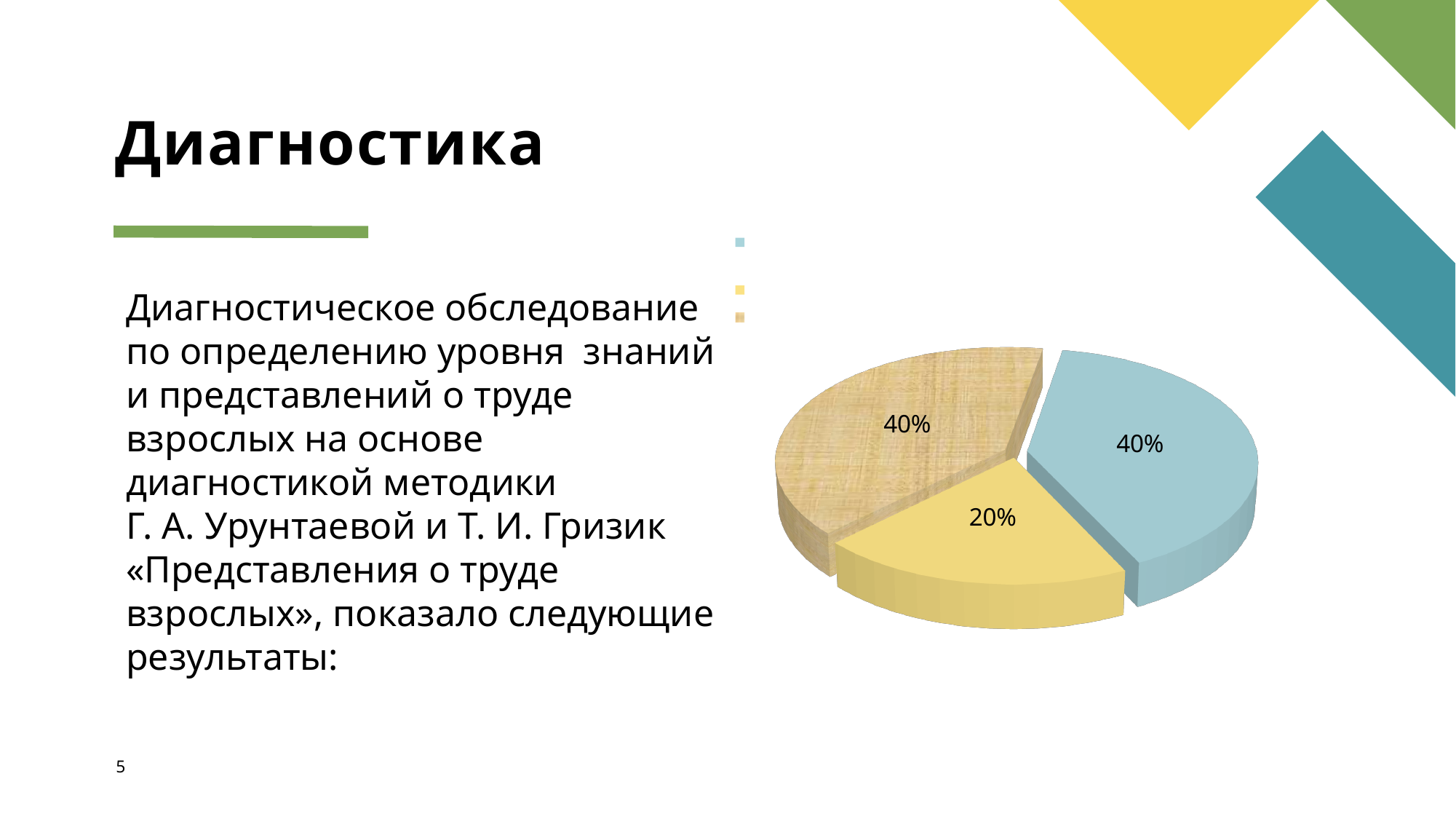
What do the three slices of the pie chart add up to? 100% How many slices does the pie chart have? 3 How many entries does the legend of the pie chart list? 3 What is the title of the slide containing the pie chart? Диагностика What percentage is shown on the light blue slice of the pie chart? 40% What percentage is shown on the wood-textured slice of the pie chart? 40% What is the difference between the light blue slice and the yellow slice of the pie chart? 20% What percentage is shown on the yellow slice of the pie chart? 20% Which slice of the pie chart is the smallest? the yellow slice (20%) How many slices of the pie chart are labelled 40%? 2 What kind of chart is shown on the slide? pie chart Which is larger in the pie chart, the wood-textured slice or the yellow slice? the wood-textured slice